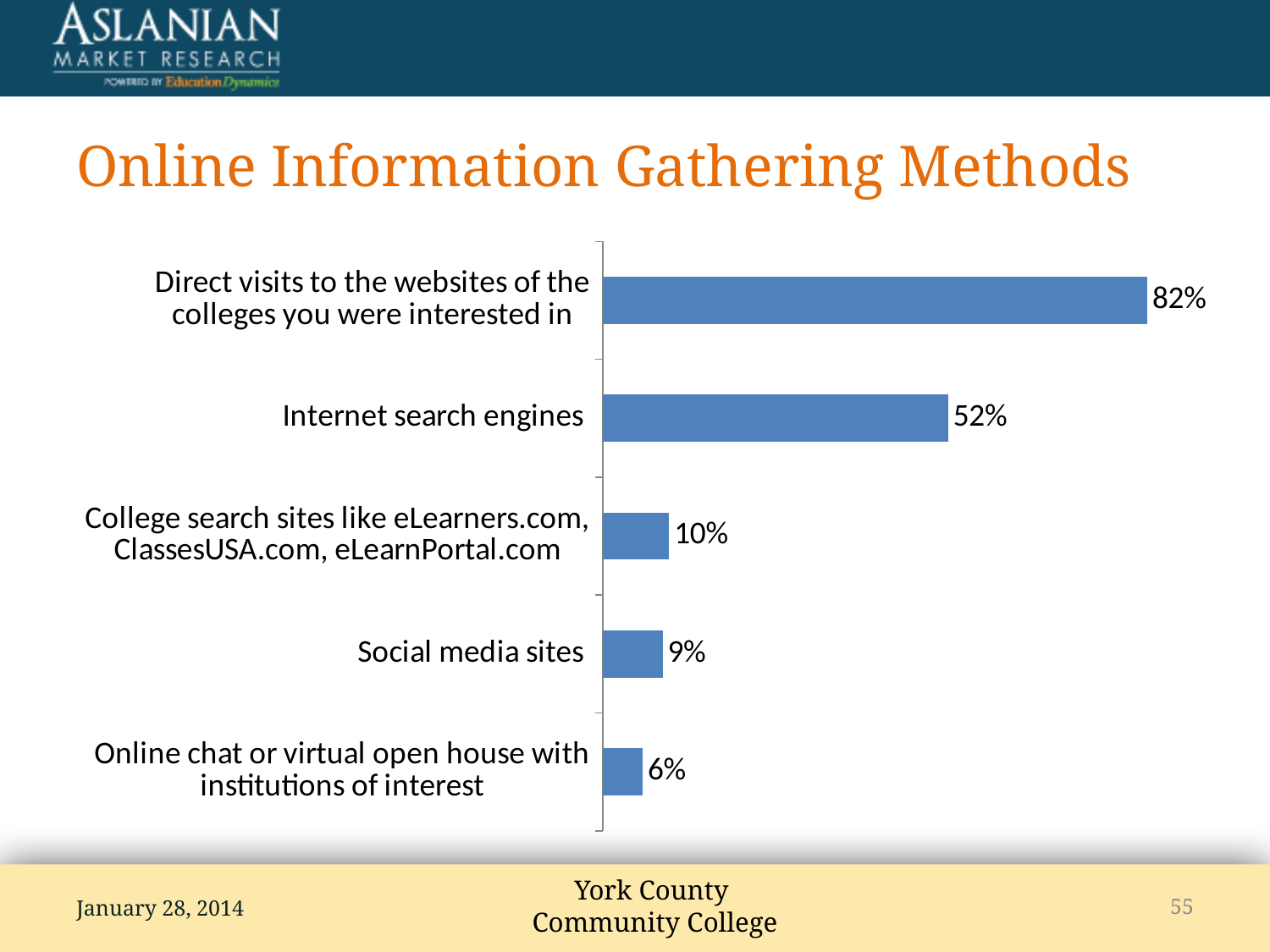
Which method has the highest percentage? Direct visits to the websites of the colleges you were interested in What is the difference between the percentages for College search sites and Social media sites? 1% How many methods are shown in the chart? 5 What is the title of the slide? Online Information Gathering Methods What is the value for Social media sites? 9% What percentage is shown for Online chat or virtual open house with institutions of interest? 6% What kind of chart is shown on the slide? Bar chart What percentage is shown for Internet search engines? 52% Which method has the lowest percentage? Online chat or virtual open house with institutions of interest What is the value for College search sites like eLearners.com, ClassesUSA.com, eLearnPortal.com? 10% Which is larger, the value for Internet search engines or the value for Social media sites? Internet search engines What is the difference between the percentages for Direct visits to the websites of the colleges you were interested in and Internet search engines? 30%